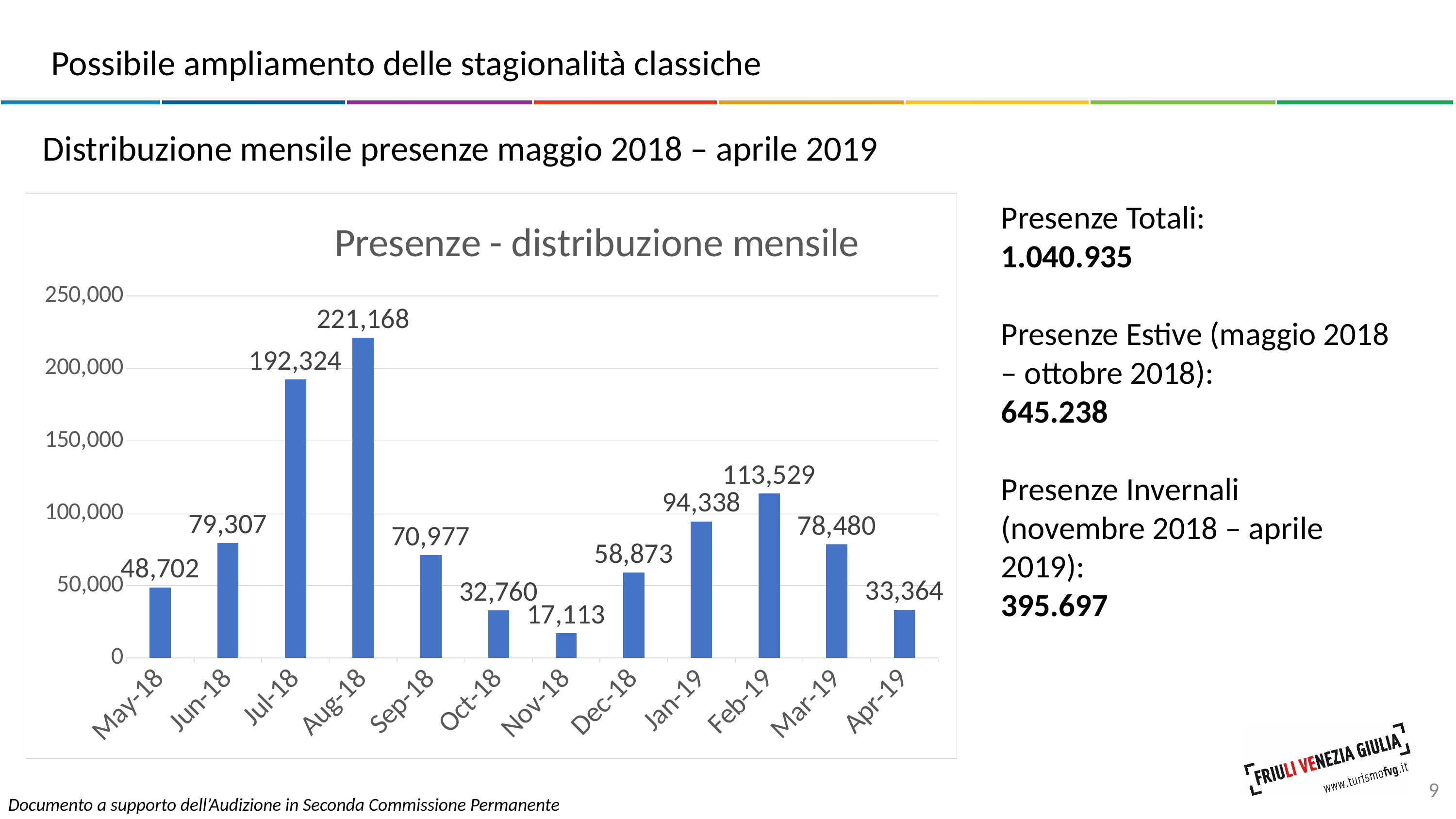
What is the value for Feb-19 in the chart? 113,529 Which is larger, the value for Jun-18 or the value for Mar-19? Jun-18 How many months are shown on the x axis of the chart? 12 What is the difference between the values for Feb-19 and Jan-19? 19,191 What is the value for Nov-18 in the chart? 17,113 What is the title of the chart? Presenze - distribuzione mensile Is the value for Jul-18 greater or less than 150,000? greater What is the difference between the values for Aug-18 and Jul-18? 28,844 What is the value for Aug-18 in the chart? 221,168 Which month has the lowest value in the chart? Nov-18 What kind of chart is shown on the slide? bar chart Which month has the highest value in the chart? Aug-18